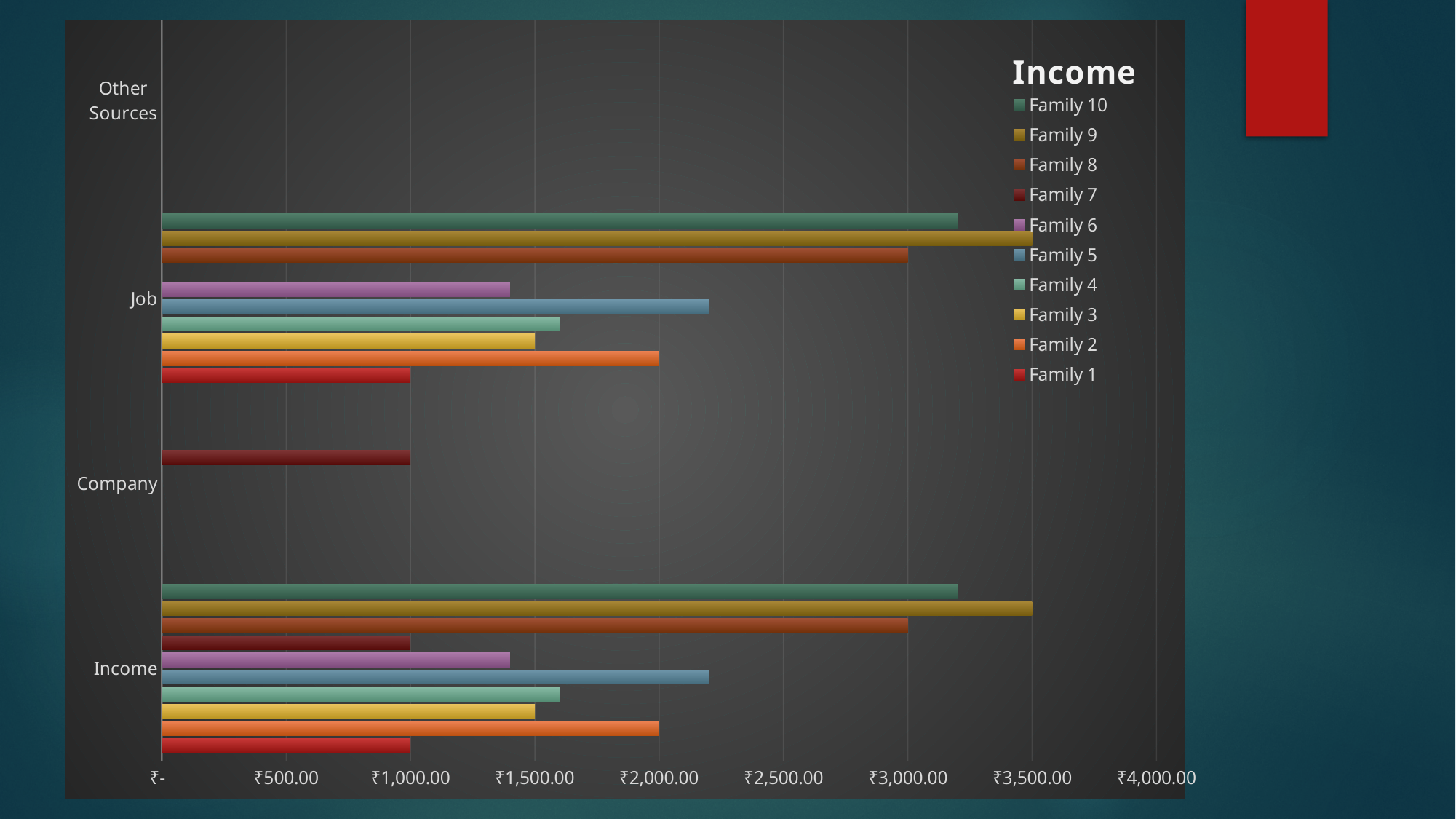
In the Income category, which is larger: the value for Family 5 or the value for Family 4? Family 5 What is the value for Family 9 in the Income category? ₹3,500.00 What is the title of the chart? Income What is the value for Family 2 in the Income category? ₹2,000.00 What kind of chart is shown on the slide? bar chart Which family is the only one with a bar in the Company category? Family 7 Which family has the highest value in the Job category? Family 9 How many series does the legend list? 10 Is the value for Family 10 in the Income category greater or less than ₹3,000.00? greater What is the value for Family 7 in the Company category? ₹1,000.00 How many categories are shown on the vertical axis? 4 What is the value for Family 8 in the Job category? ₹3,000.00